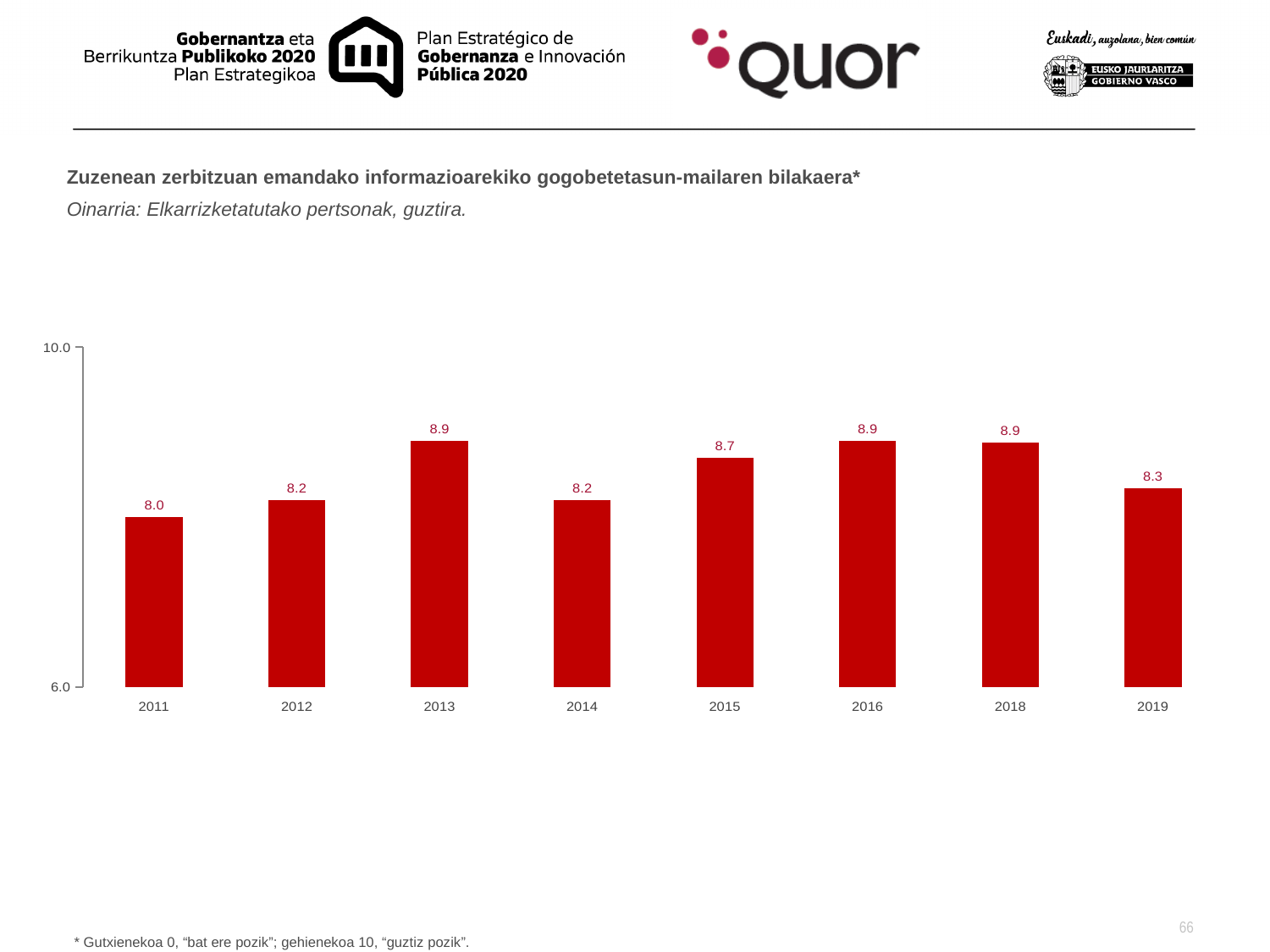
What is the difference between the values for 2018 and 2019? 0.6 What is the difference between the values for 2013 and 2011? 0.9 Does the value rise or fall from 2018 to 2019? fall What is the value for 2015? 8.7 Which is larger, the value for 2012 or the value for 2019? 2019 How many years are shown on the x axis? 8 What kind of chart is this? bar chart Which year has the lowest value? 2011 What is the value for 2011? 8.0 What is the highest value shown on the y axis? 10.0 What is the value for 2019? 8.3 Which is larger, the value for 2014 or the value for 2015? 2015